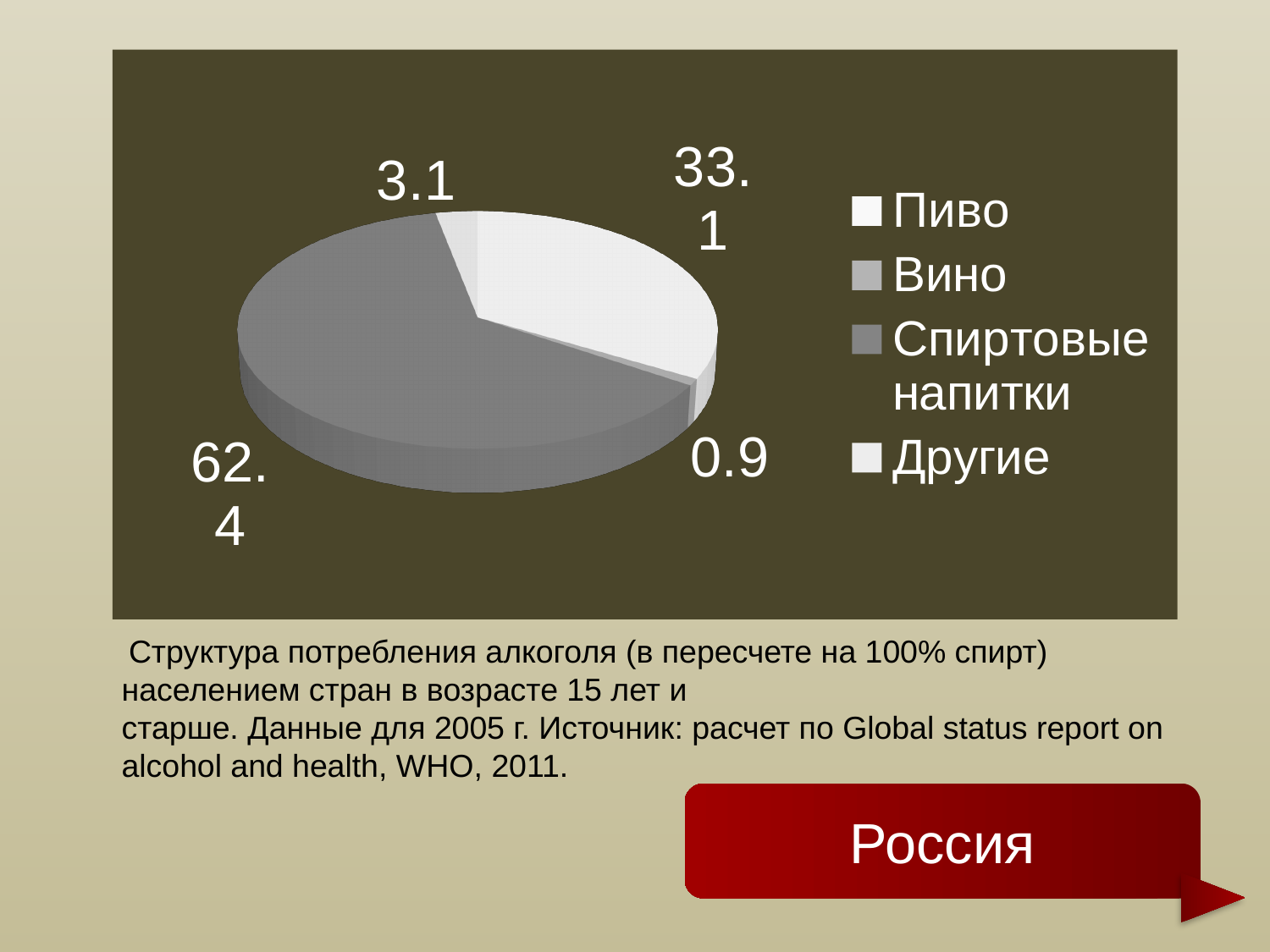
Which category has the largest slice of the pie? Спиртовые напитки What is the value shown for Вино in the pie chart? 0.9 How many entries does the legend list? 4 What is the value shown for Другие in the pie chart? 3.1 What type of chart is shown on the slide? Pie chart Which is larger, the value for Другие or the value for Вино? Другие Which country is named in the red box below the chart? Россия What is the difference between the values for Спиртовые напитки and Пиво? 29.3 Which category has the smallest slice of the pie? Вино What is the value shown for Спиртовые напитки in the pie chart? 62.4 How many categories does the pie chart have? 4 What is the value shown for Пиво in the pie chart? 33.1